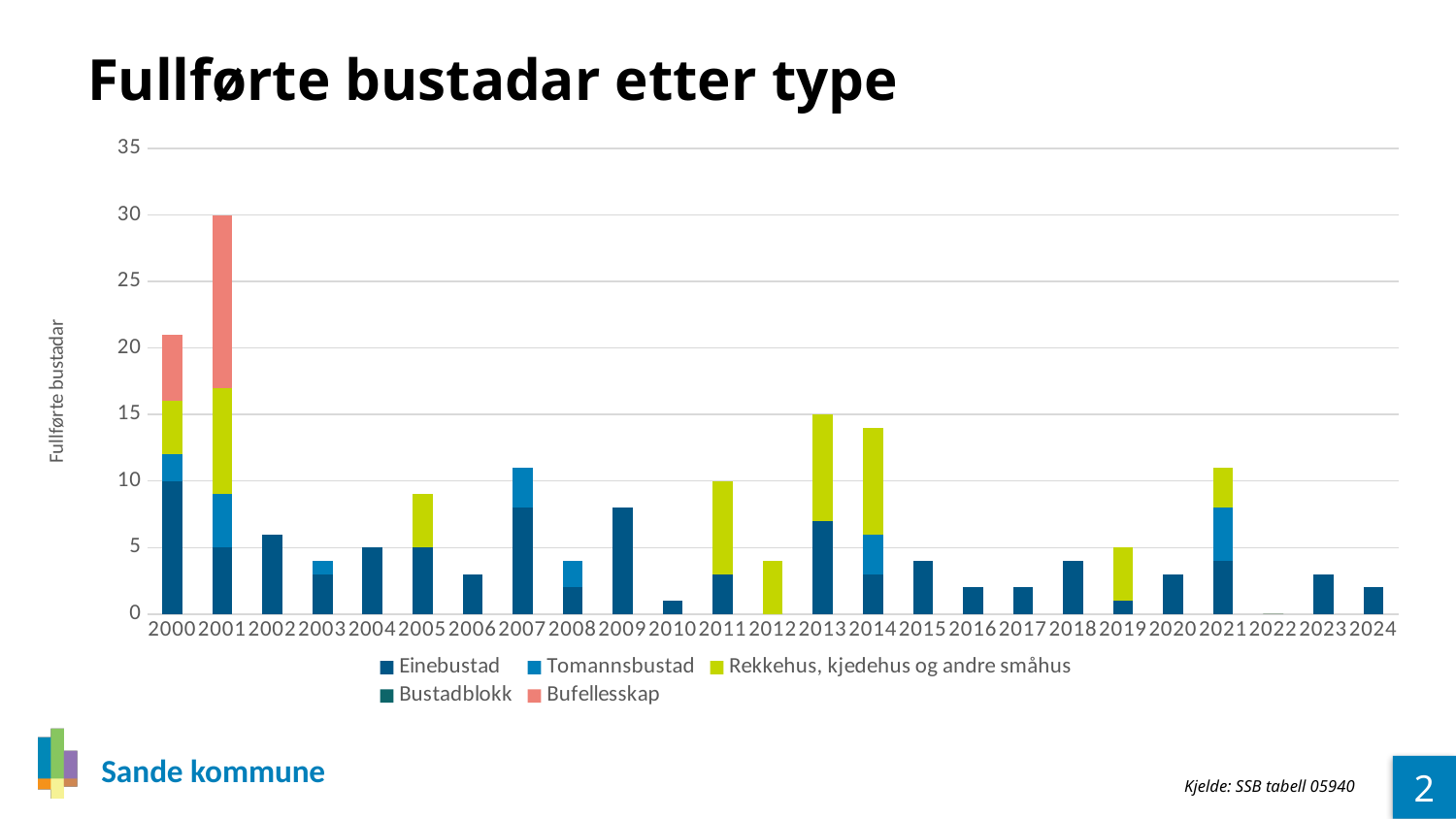
Is the total value for 2009 greater or less than 10? less What is the total height of the stacked bar for 2001? 30 How many years are shown on the x axis? 25 What is the difference between the total for 2001 and the total for 2013? 15 Which year has the highest total of completed dwellings? 2001 What is the title of the chart? Fullførte bustadar etter type How many series does the legend list? 5 What kind of chart is shown on the slide? Stacked bar chart Which year has the lowest total, with no bar shown at all? 2022 What is the total height of the stacked bar for 2011? 10 What is the total height of the stacked bar for 2013? 15 Which year has the larger total, 2000 or 2001? 2001